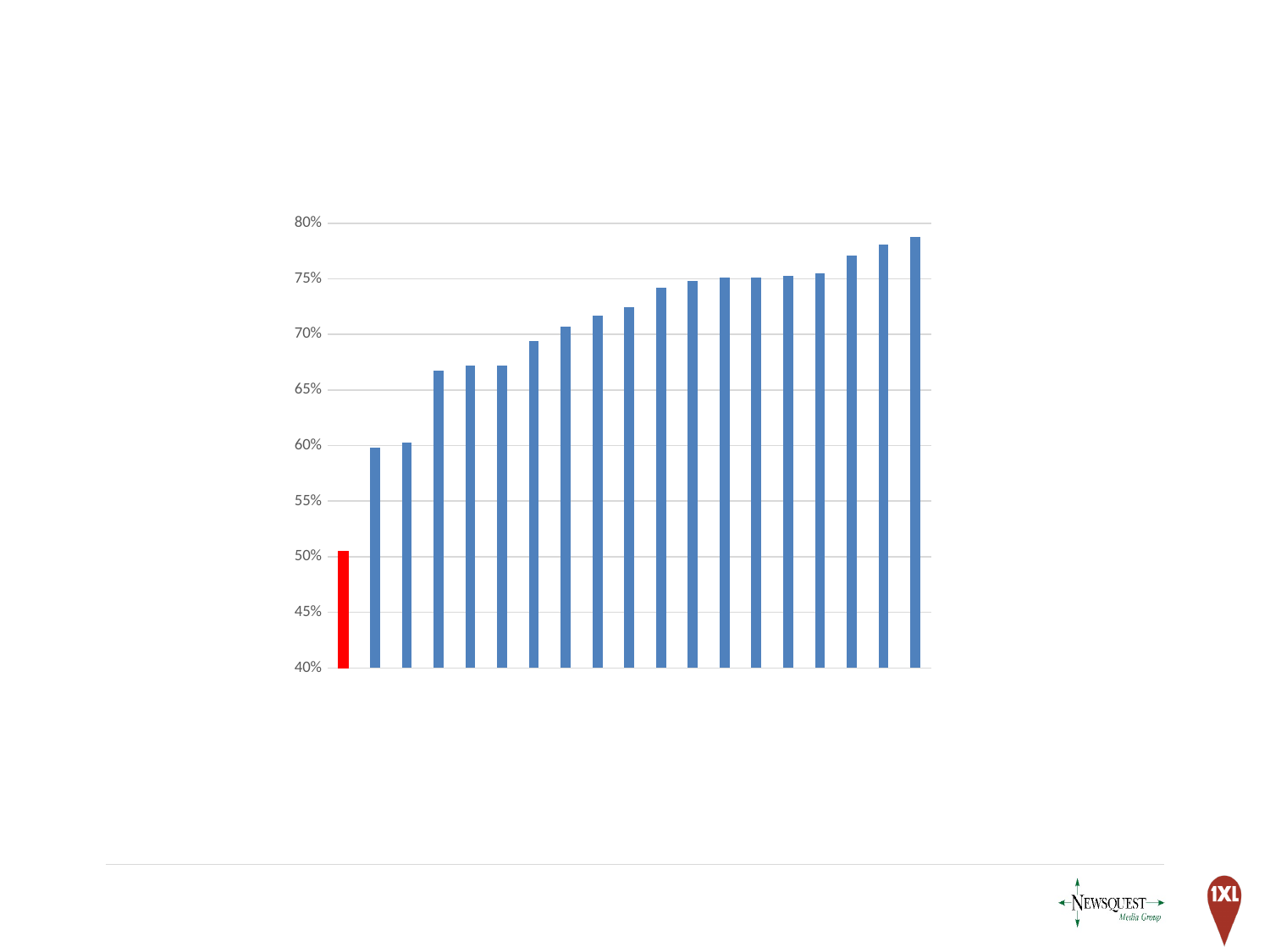
Is the value of the rightmost bar greater or less than 75%? greater What colour is the leftmost bar, which differs from all the others? red Is the value of the second bar from the left greater or less than 55%? greater Which is larger, the value of the red bar or the value of the rightmost blue bar? the rightmost blue bar What kind of chart is shown on the slide? bar chart How many bars are plotted in the chart? 19 Is the value of the rightmost bar greater or less than 80%? less Do the bar values rise or fall from left to right across the chart? rise Which bar has the highest value in the chart? the rightmost bar Which bar has the lowest value, the leftmost or the rightmost? the leftmost